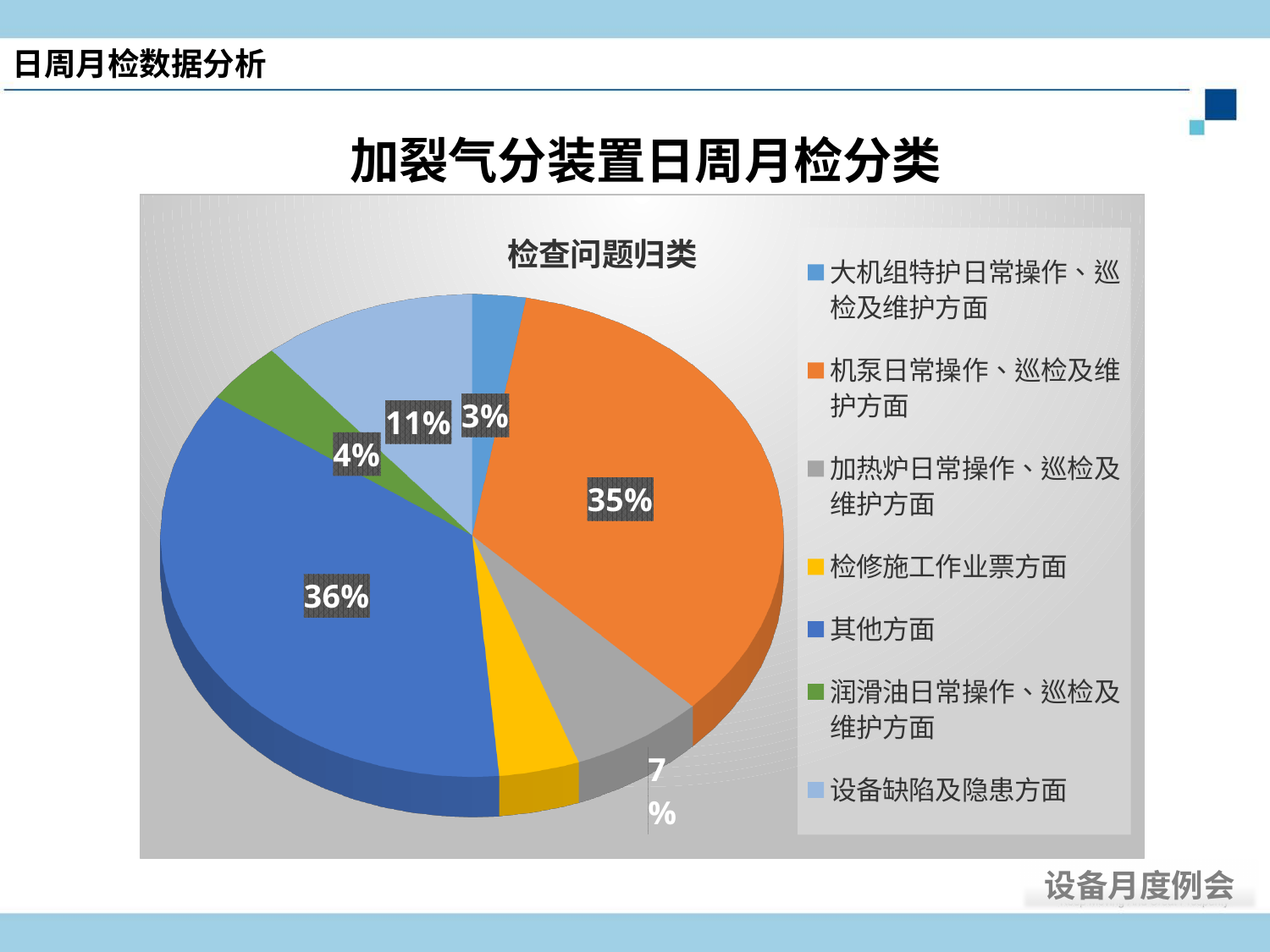
What is the difference between the shares of 其他方面 and 机泵日常操作、巡检及维护方面? 1% What percentage is shown for 设备缺陷及隐患方面? 11% Which category has the largest share of the pie? 其他方面 What percentage is shown for 机泵日常操作、巡检及维护方面? 35% What percentage is shown for 其他方面? 36% What percentage is shown for 润滑油日常操作、巡检及维护方面? 4% What percentage is shown for 大机组特护日常操作、巡检及维护方面? 3% What percentage is shown for 加热炉日常操作、巡检及维护方面? 7% Which is larger, the share for 设备缺陷及隐患方面 or the share for 加热炉日常操作、巡检及维护方面? 设备缺陷及隐患方面 What type of chart is shown on the slide? pie chart How many categories does the legend list? 7 What is the title of the chart? 检查问题归类